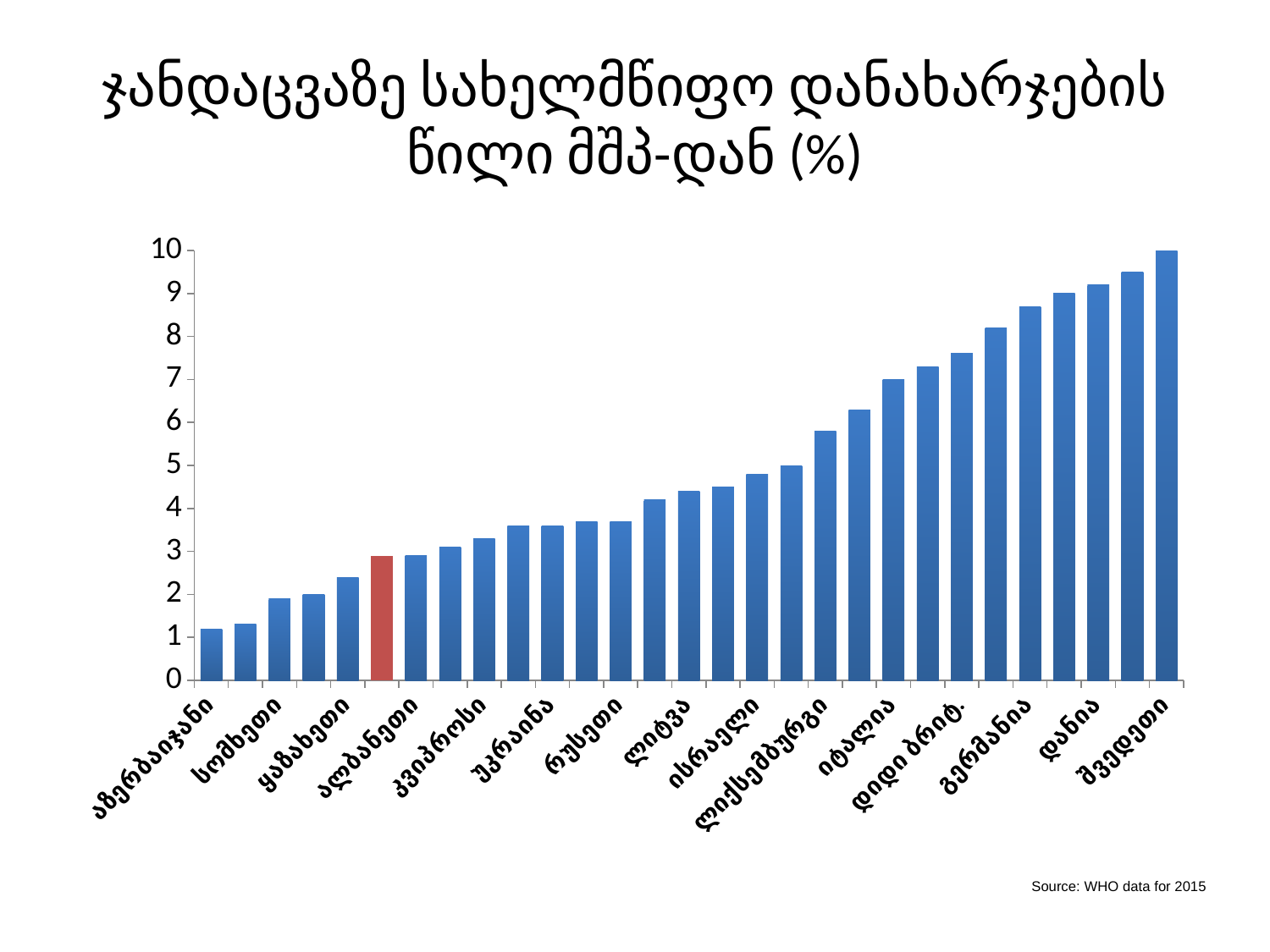
Do the values rise or fall from left to right along the x axis? rise Is the value for გერმანია greater or less than 8? greater What kind of chart is shown on the slide? bar chart Is the value for ლიუქსემბურგი greater or less than 5? greater Which country has the highest value in the chart? შვედეთი How many bars are shown in a different colour (red) from the rest? 1 Which country has the lowest value in the chart? აზერბაიჯანი What is the value for შვედეთი? 10 Which is larger, the value for გერმანია or the value for იტალია? გერმანია Is the value for ყაზახეთი greater or less than 3? less